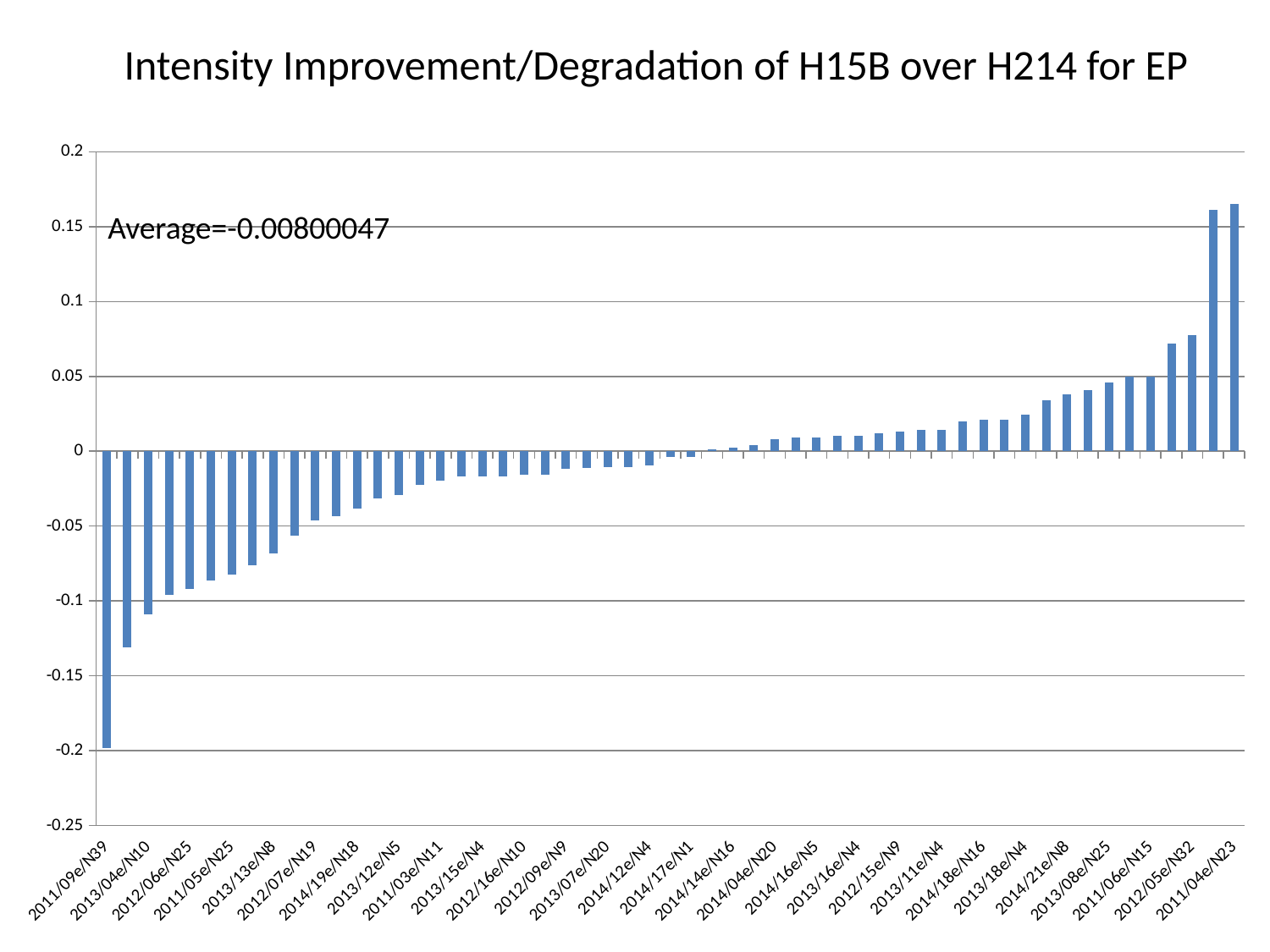
What kind of chart is shown on the slide? bar chart Which category has the highest value? 2011/04e/N23 Is the value for 2013/04e/N10 greater or less than -0.05? less What average value is printed on the chart? -0.00800047 Which is larger, the value for 2011/09e/N39 or the value for 2011/04e/N23? 2011/04e/N23 Is the value for 2011/09e/N39 greater or less than -0.15? less Is the value for 2012/06e/N25 greater or less than -0.05? less Which category has the lowest value? 2011/09e/N39 Do the bar values rise or fall moving from left to right along the x axis? rise What is the title of the chart? Intensity Improvement/Degradation of H15B over H214 for EP